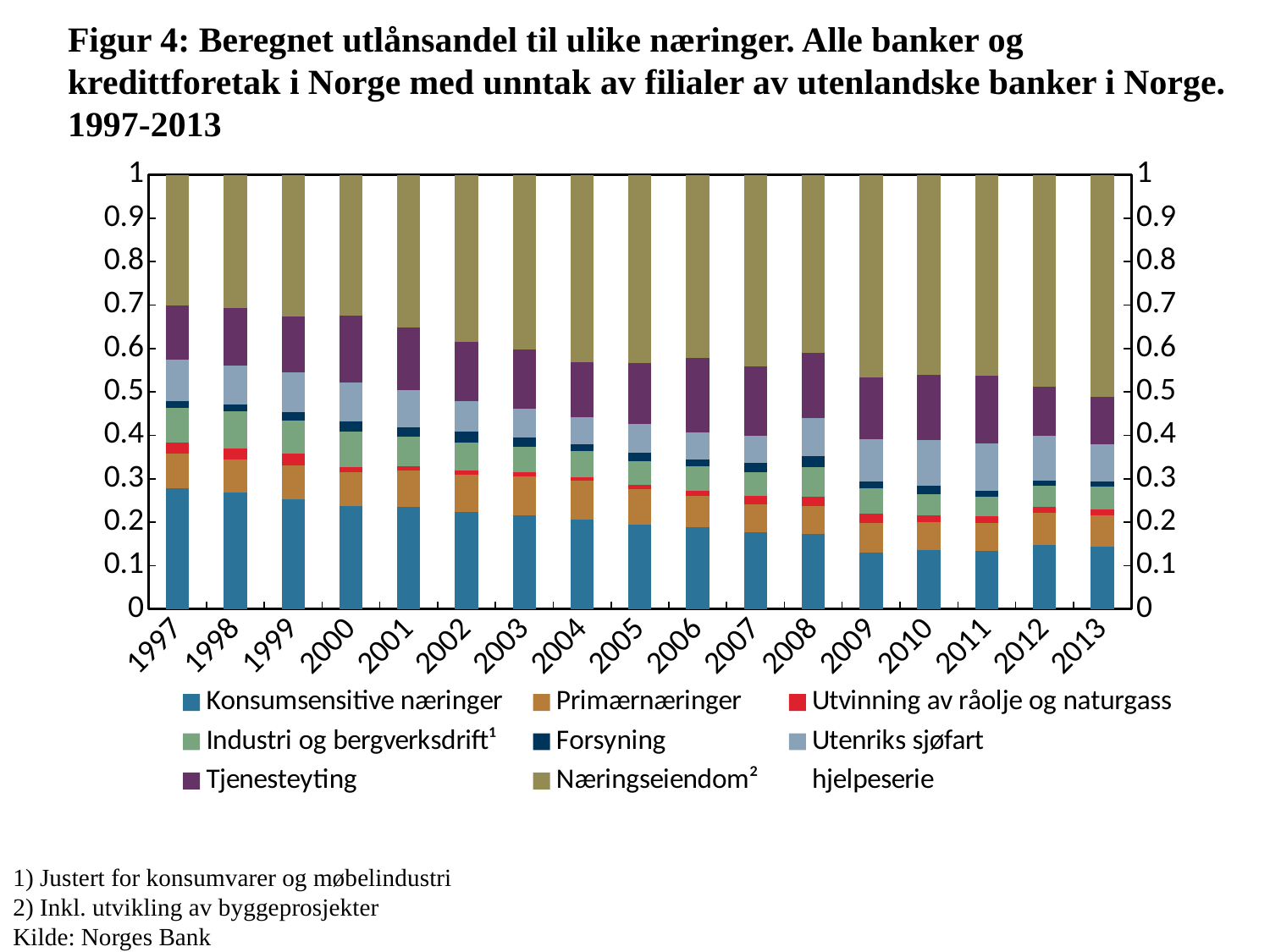
What kind of chart is shown on the slide? Stacked bar chart How many series does the legend list? 9 Does the share for Konsumsensitive næringer rise or fall from 1997 to 2013? fall Which is larger, the value for Konsumsensitive næringer in 1997 or in 2013? 1997 Is the value for Konsumsensitive næringer in 2013 greater or less than 0.2? less Is the value for Konsumsensitive næringer in 2009 greater or less than 0.2? less Is the value for Konsumsensitive næringer in 1997 greater or less than 0.2? greater What source is cited below the chart? Norges Bank Does the share for Næringseiendom² rise or fall from 1997 to 2013? rise How many years are shown along the x axis of the chart? 17 What is the total of the stacked bar for 1997? 1 Which year is the first category on the x axis? 1997